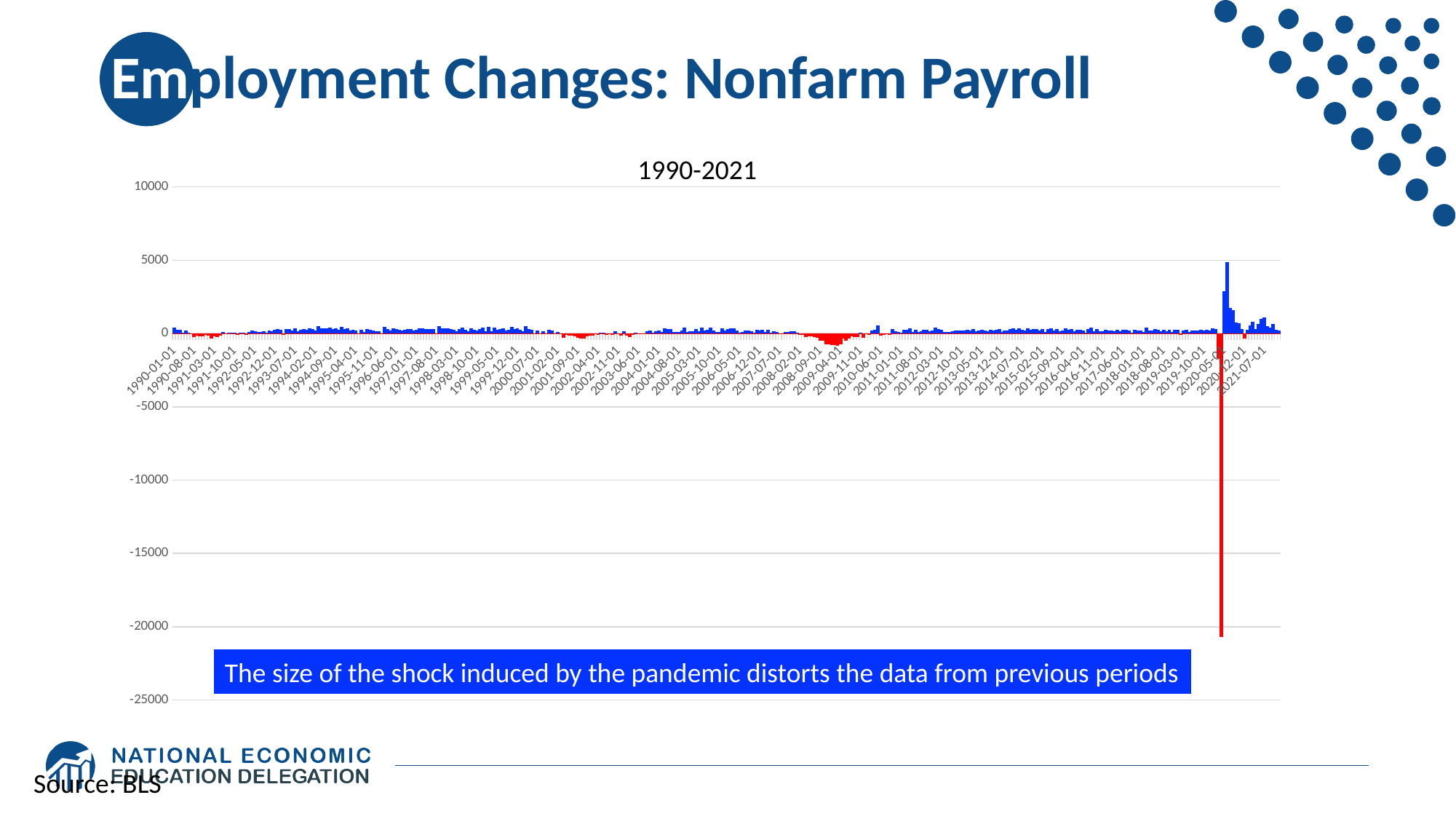
What kind of chart is shown on the slide? bar chart Is the value for the largest blue bar in 2020 greater or less than 10000? less What colour are the negative bars on the chart? red Is the lowest value on the chart (the large red bar in 2020) greater or less than -20000? less Is the lowest value on the chart (the large red bar in 2020) greater or less than -15000? less In which year does the lowest value on the chart occur? 2020 What is the title of the chart? 1990-2021 Which is larger in magnitude: the largest negative bar in 2020 or the largest negative bar in 2009? the largest negative bar in 2020